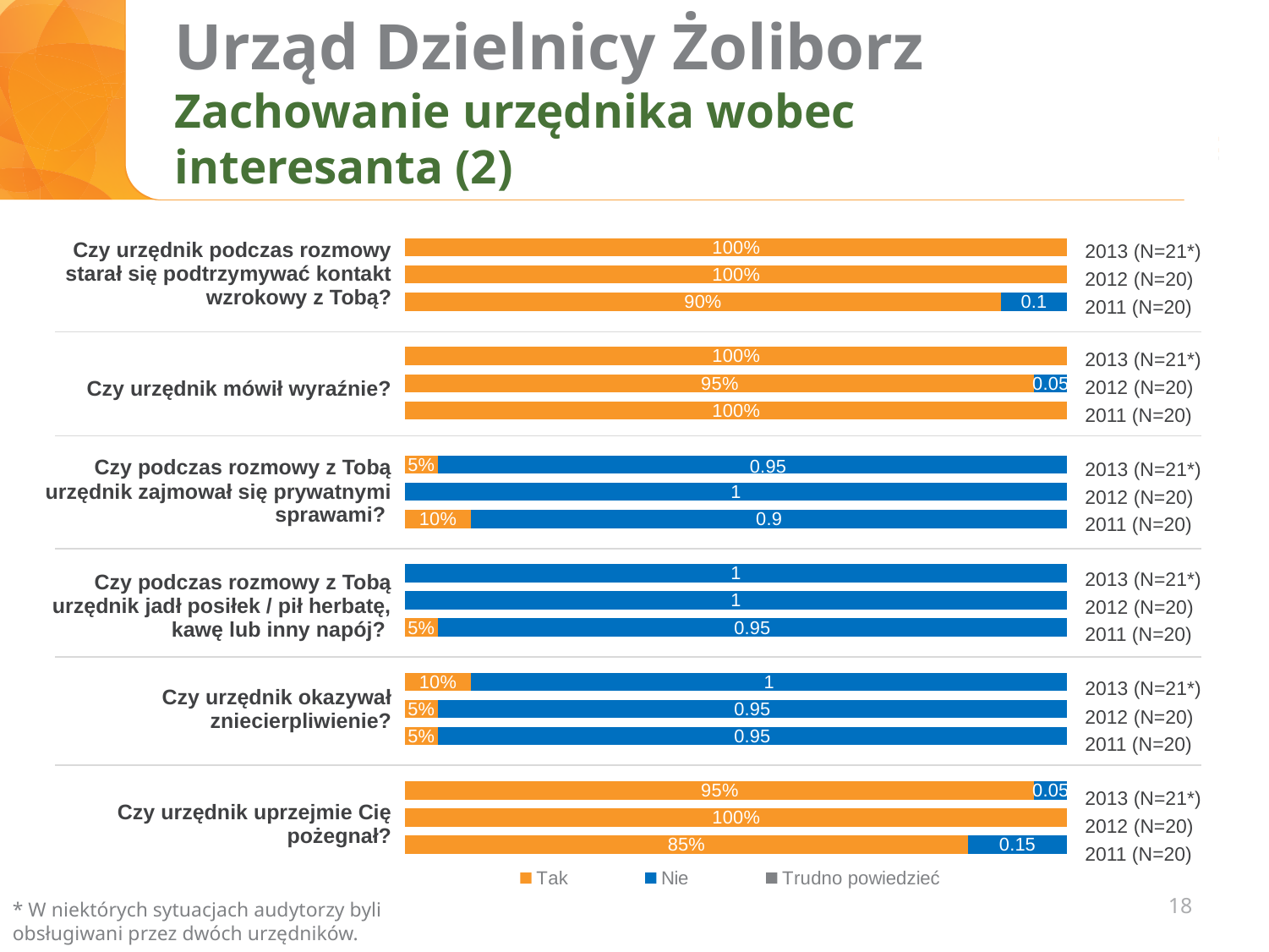
What is the 'Tak' value for 2012 for the question 'Czy urzędnik mówił wyraźnie?'? 95% For the question 'Czy urzędnik uprzejmie Cię pożegnał?', which year has the lowest 'Tak' value? 2011 (N=20) What is the 'Nie' value for 2011 for the question 'Czy urzędnik uprzejmie Cię pożegnał?'? 0.15 What kind of chart is shown on the slide? bar chart How many series does the chart legend list? 3 What is the 'Nie' value for 2011 for the question 'Czy podczas rozmowy z Tobą urzędnik zajmował się prywatnymi sprawami?'? 0.9 What is the 'Tak' value for 2013 for the question 'Czy urzędnik okazywał zniecierpliwienie?'? 10% What is the 'Tak' value for 2011 for the question 'Czy urzędnik podczas rozmowy starał się podtrzymywać kontakt wzrokowy z Tobą?'? 90% What is the 'Nie' value for 2011 for the question 'Czy urzędnik podczas rozmowy starał się podtrzymywać kontakt wzrokowy z Tobą?'? 0.1 Which colour represents the 'Nie' series in the chart? blue How many survey questions (categories) are shown in the chart? 6 What is the 'Tak' value for 2011 for the question 'Czy urzędnik uprzejmie Cię pożegnał?'? 85%